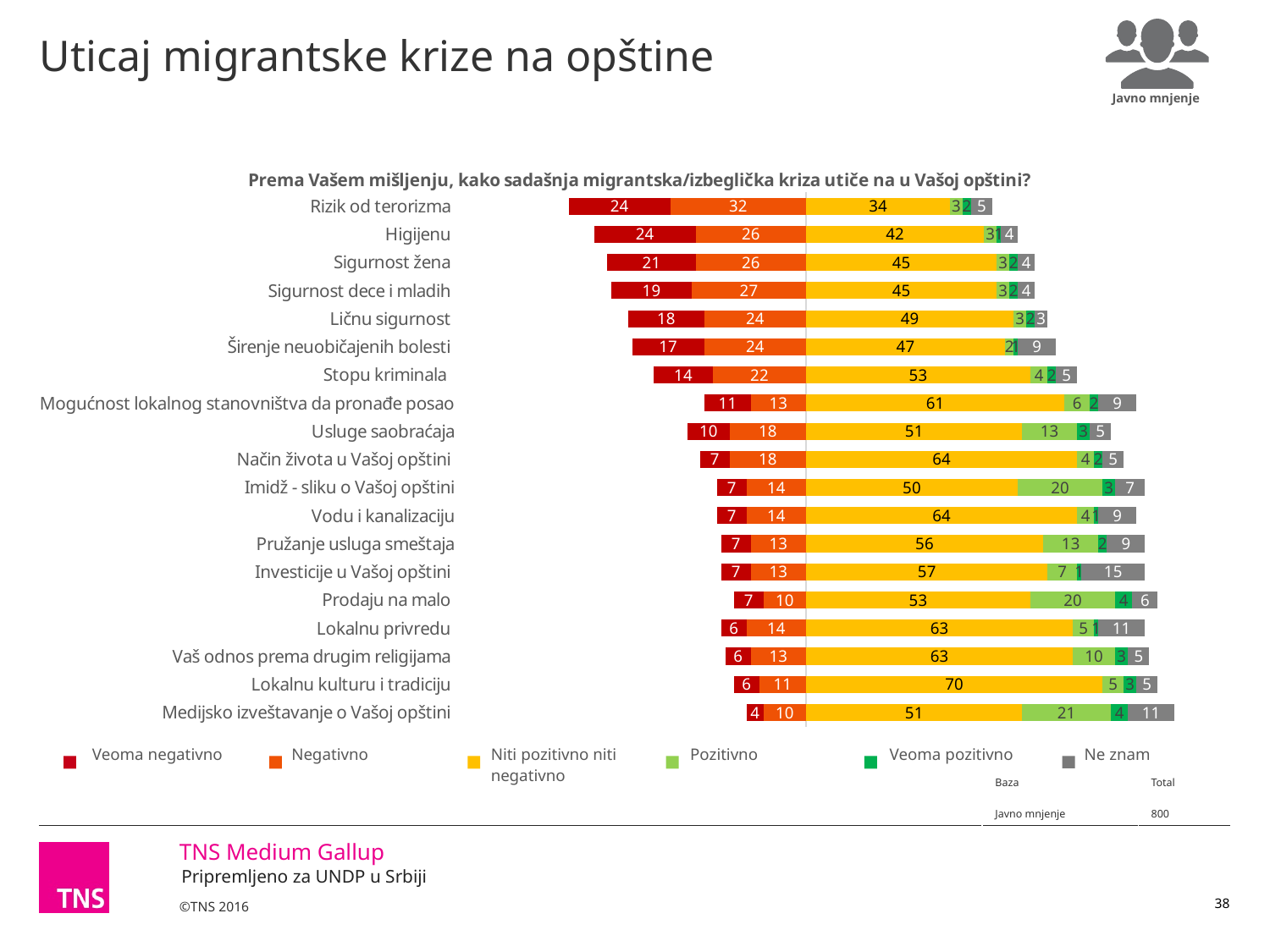
What kind of chart is shown on the slide? Stacked bar chart What is the 'Veoma negativno' value for 'Rizik od terorizma'? 24 Which has a larger 'Pozitivno' value: 'Imidž - sliku o Vašoj opštini' or 'Usluge saobraćaja'? Imidž - sliku o Vašoj opštini How many series does the legend list? 6 Which category has the highest 'Niti pozitivno niti negativno' value? Lokalnu kulturu i tradiciju What is the 'Niti pozitivno niti negativno' value for 'Lokalnu kulturu i tradiciju'? 70 What is the total of the stacked bar for 'Rizik od terorizma'? 100 What is the 'Ne znam' value for 'Investicije u Vašoj opštini'? 15 What is the 'Pozitivno' value for 'Medijsko izveštavanje o Vašoj opštini'? 21 What is the difference between the 'Negativno' values for 'Rizik od terorizma' and 'Stopu kriminala'? 10 How many categories are shown in the chart? 19 Which category has the lowest 'Veoma negativno' value? Medijsko izveštavanje o Vašoj opštini